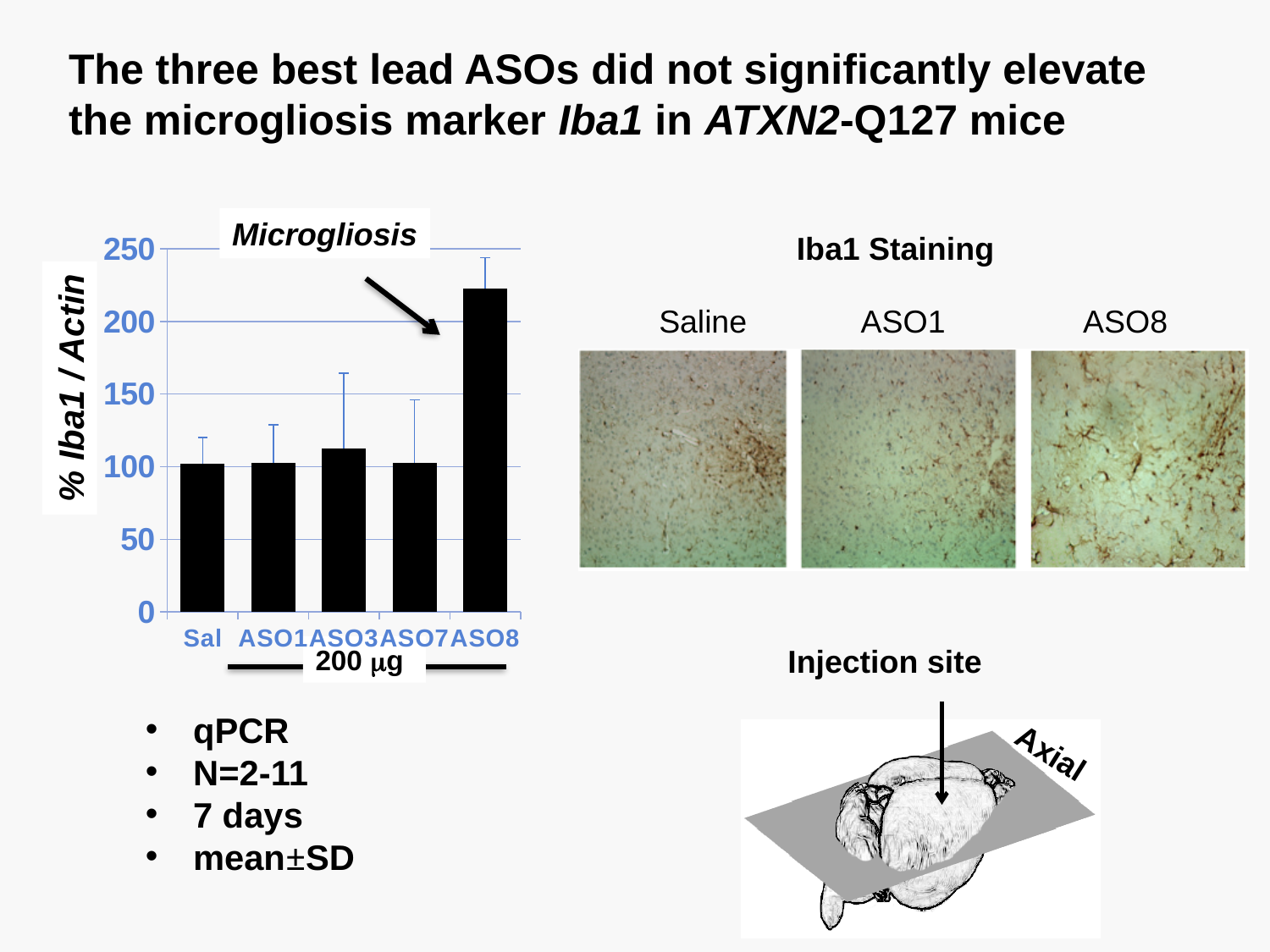
In the Microgliosis chart, which is larger, the value for ASO8 or the value for Sal? ASO8 In the Microgliosis chart, is the value for ASO3 greater or less than 100? greater What is the y-axis label of the Microgliosis chart? % Iba1 / Actin In the Microgliosis chart, is the value for ASO7 greater or less than 50? greater What kind of chart is the Microgliosis chart? bar chart What dose is indicated beneath the x-axis categories of the Microgliosis chart? 200 µg Which category has the highest bar in the Microgliosis chart? ASO8 In the Microgliosis chart, is the value for Sal greater or less than 150? less In the Microgliosis chart, which is larger, the value for ASO3 or the value for ASO8? ASO8 How many categories are shown on the x axis of the Microgliosis chart? 5